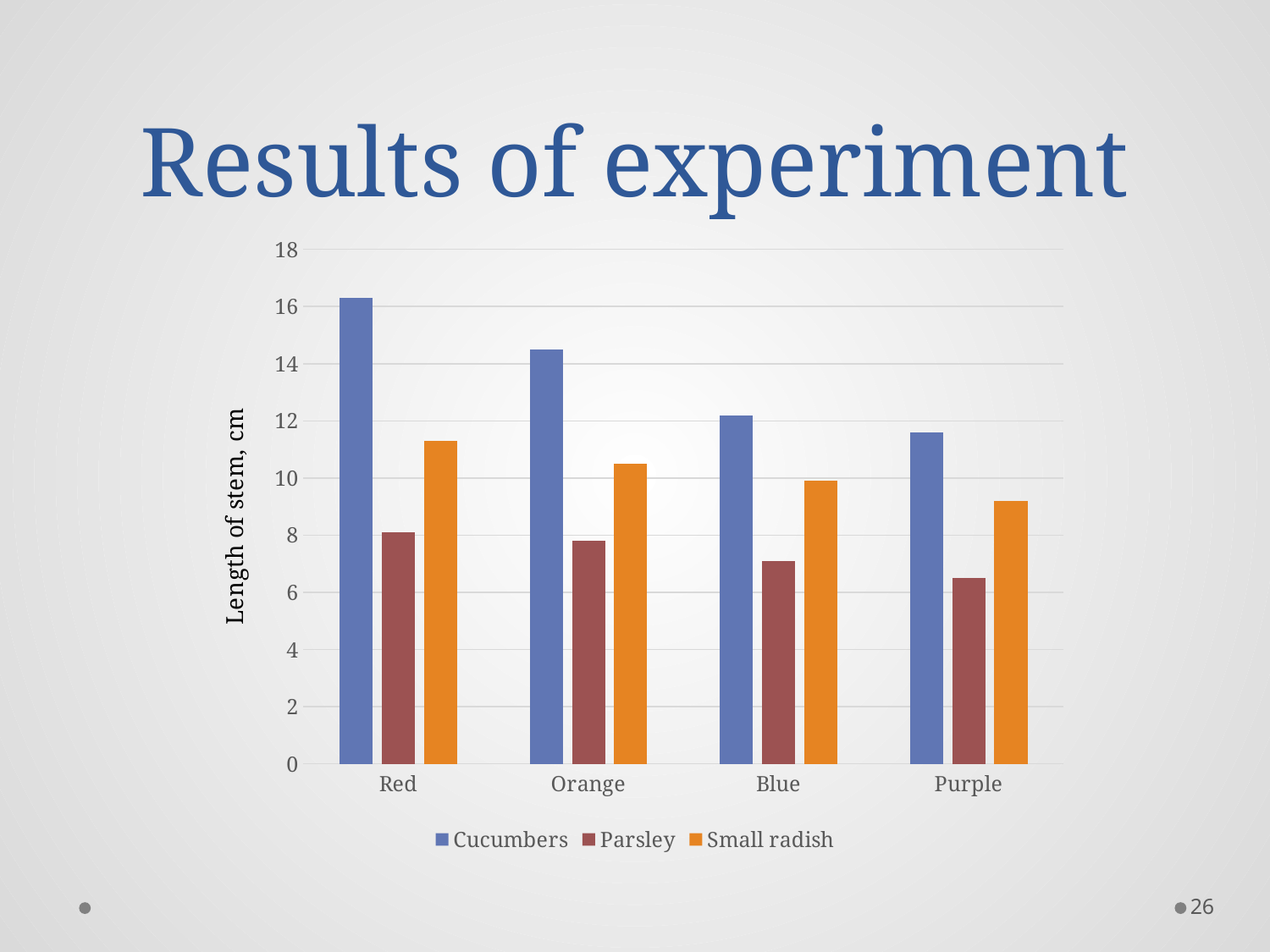
Do the Cucumbers values rise or fall from Red to Purple along the x axis? fall How many series does the legend list? 3 What kind of chart is shown on the slide? bar chart Is the value for Parsley in the Purple category greater or less than 8? less Is the value for Cucumbers in the Red category greater or less than 14? greater Which category has the lowest value for Parsley? Purple For the Blue category, which is larger: Cucumbers or Small radish? Cucumbers How many categories are shown on the x axis? 4 Is the value for Small radish in the Red category greater or less than 10? greater Which category has the lowest value for Small radish? Purple What is the label of the vertical axis? Length of stem, cm Which category has the highest value for Cucumbers? Red